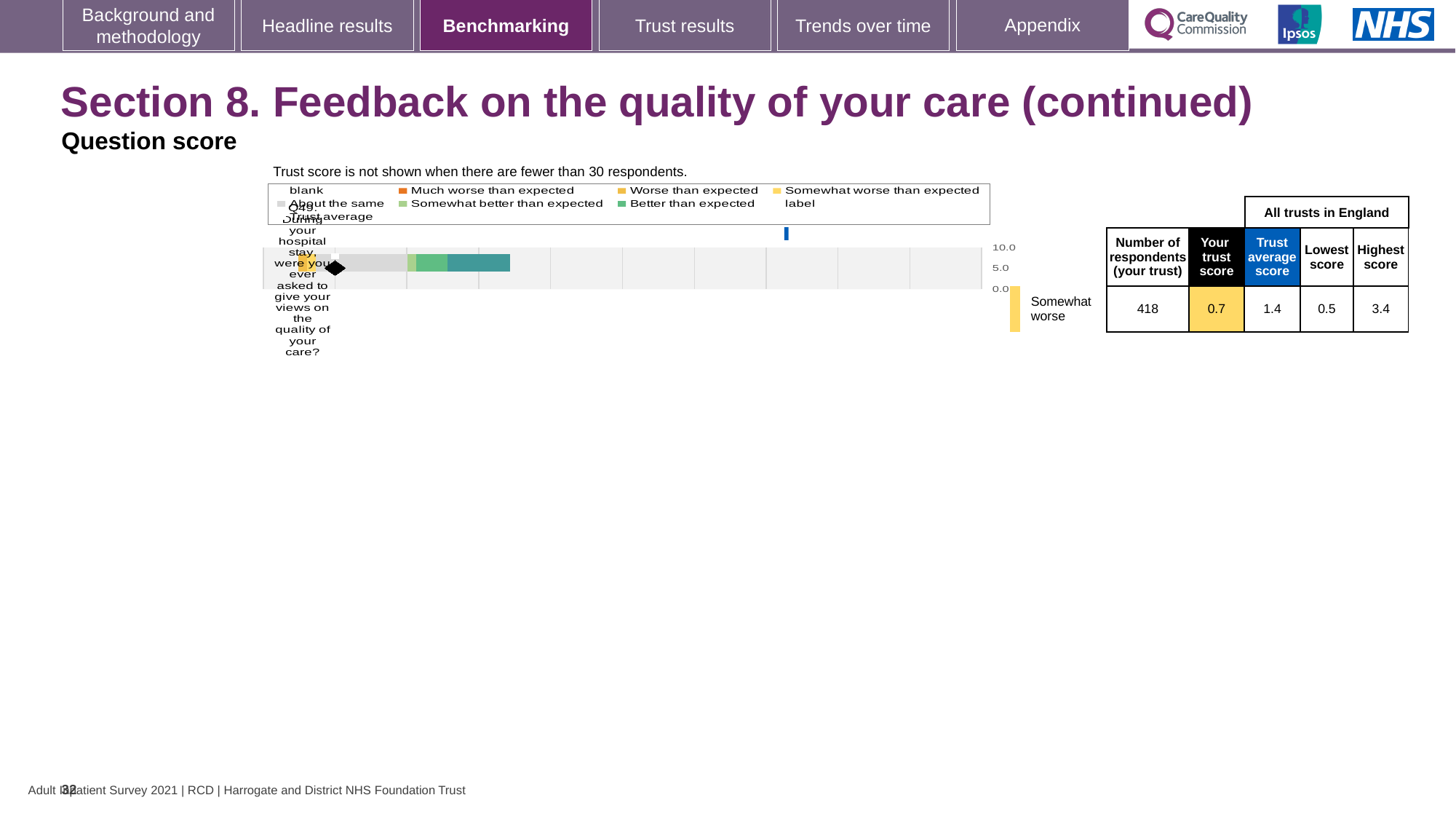
What kind of chart is used to show the Q49 benchmark? Bar chart What is the trust score for Q49 (During your hospital stay, were you ever asked to give your views on the quality of your care?)? 0.7 How many respondents from the trust answered Q49? 418 What is the trust average score for all trusts in England for Q49? 1.4 By how much does the trust average score exceed the trust's own score for Q49? 0.7 Which benchmark category label is shown next to the Q49 chart? Somewhat worse How many questions are plotted on the benchmarking chart? 1 What is the difference between the highest score and the lowest score for Q49? 2.9 What is the lowest score among all trusts in England for Q49? 0.5 Which is larger for Q49: the trust's own score or the trust average score? Trust average score Is the trust score for Q49 greater or less than 5.0 on the chart axis? less What is the highest score among all trusts in England for Q49? 3.4